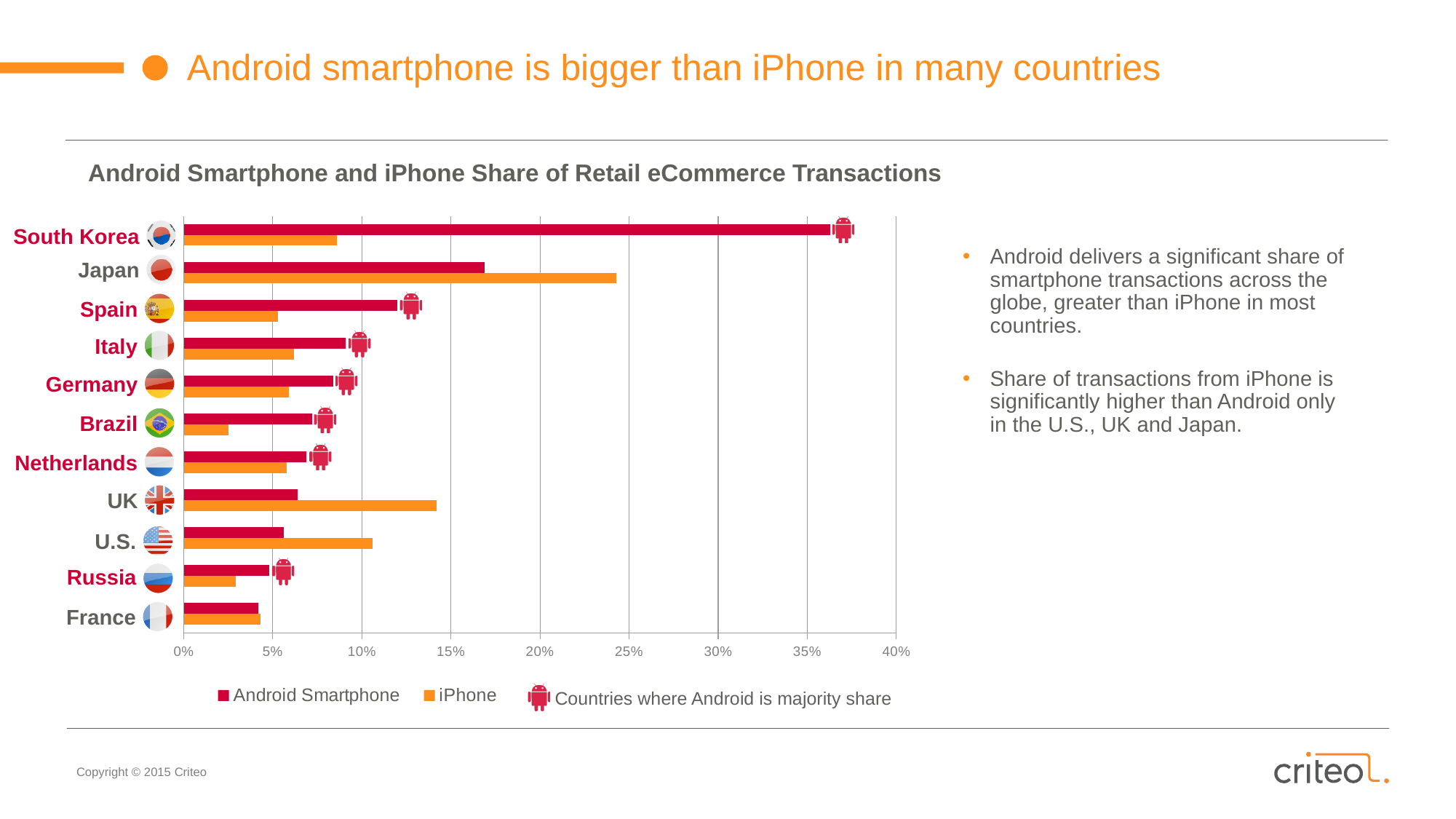
Is the Android Smartphone share for Spain greater or less than 10%? greater How many data series are plotted on the chart? 2 Which country has the lowest Android Smartphone share? France Is the Android Smartphone share for South Korea greater or less than 35%? greater What is the title of the chart? Android Smartphone and iPhone Share of Retail eCommerce Transactions For the UK, which is larger, the Android Smartphone share or the iPhone share? iPhone What type of chart is shown on the slide? bar chart Which country has the lowest iPhone share? Brazil Is the iPhone share for Japan greater or less than 20%? greater Which country has the highest Android Smartphone share? South Korea Which country has the highest iPhone share? Japan How many countries are shown on the chart? 11